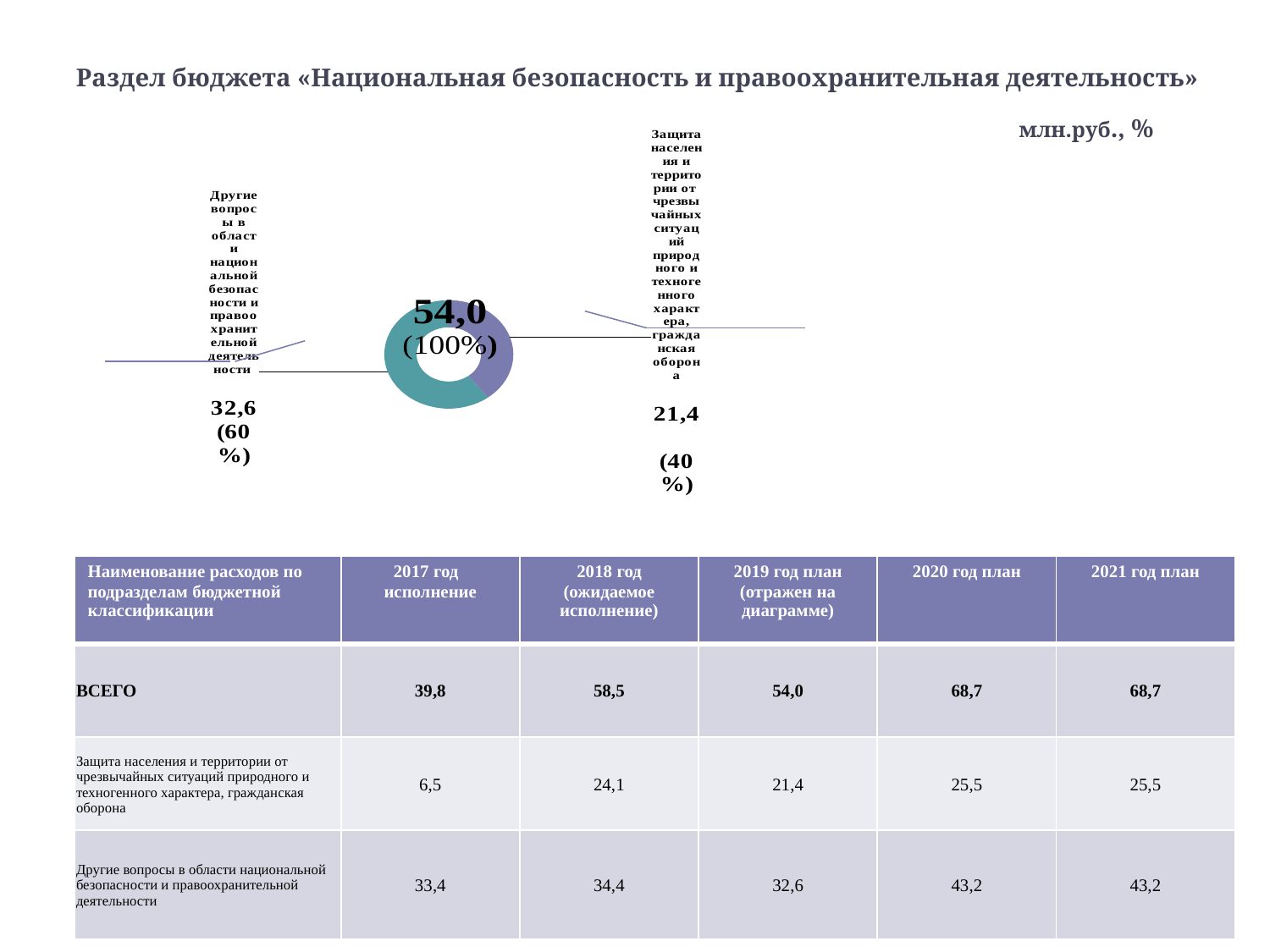
What is the value shown for «Другие вопросы в области национальной безопасности и правоохранительной деятельности» on the chart? 32,6 What units are indicated for the chart on the slide? млн.руб., % How many slices does the doughnut chart have? 2 What is the value shown for «Защита населения и территории от чрезвычайных ситуаций природного и техногенного характера, гражданская оборона» on the chart? 21,4 What share of the doughnut chart does «Защита населения и территории от чрезвычайных ситуаций природного и техногенного характера, гражданская оборона» represent? 40% What total value is shown in the centre of the doughnut chart? 54,0 (100%) What kind of chart is shown on the slide? Doughnut (pie) chart Which slice of the doughnut chart is the largest? Другие вопросы в области национальной безопасности и правоохранительной деятельности What is the difference between the values of the two slices on the doughnut chart (32,6 and 21,4)? 11,2 Which slice of the doughnut chart is the smallest? Защита населения и территории от чрезвычайных ситуаций природного и техногенного характера, гражданская оборона Which is larger on the chart: the value for «Другие вопросы...» or the value for «Защита населения...»? Другие вопросы в области национальной безопасности и правоохранительной деятельности What share of the doughnut chart does «Другие вопросы в области национальной безопасности и правоохранительной деятельности» represent? 60%